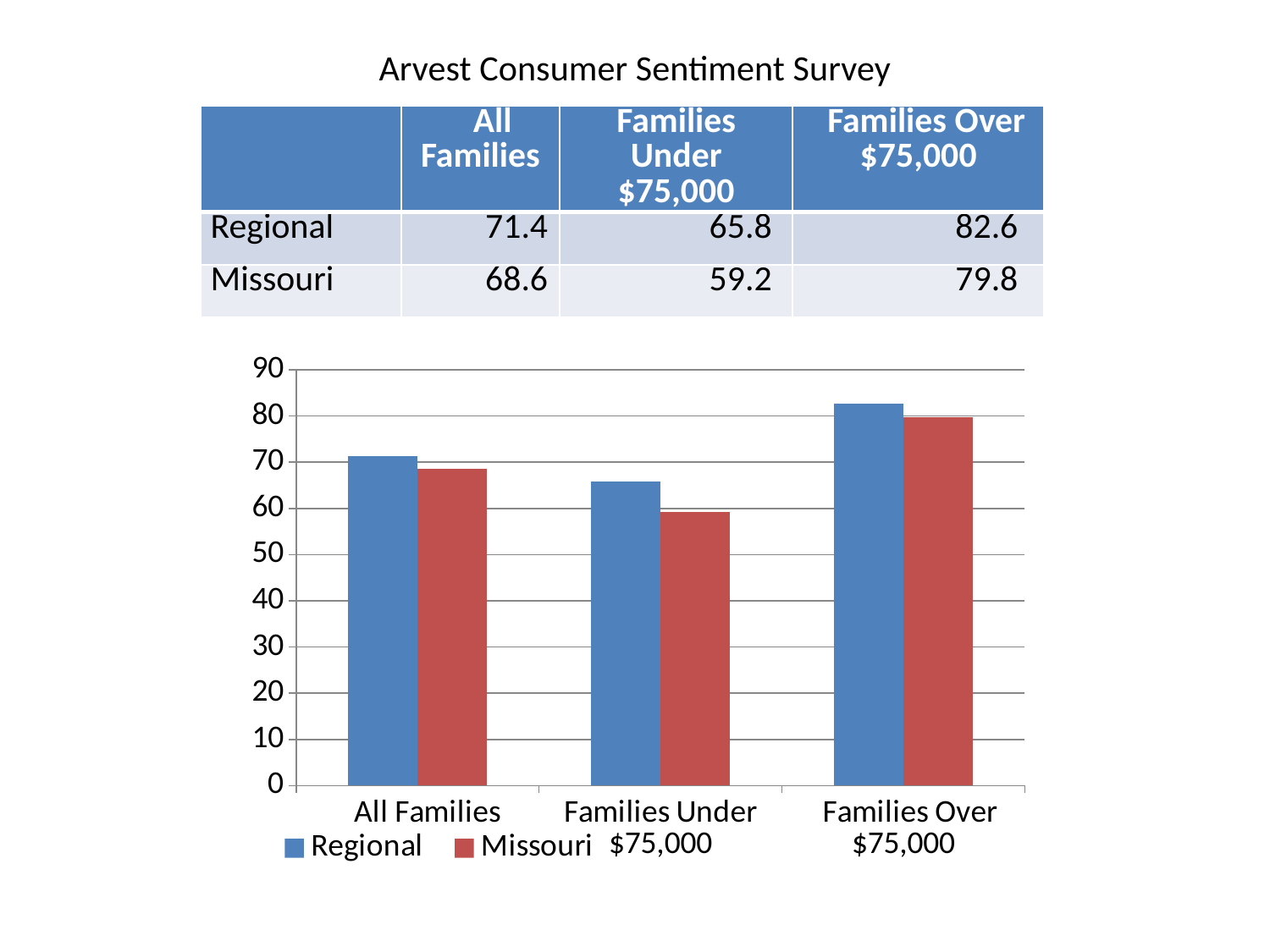
Which is larger for All Families, the Regional value or the Missouri value? Regional Which category has the highest Regional value? Families Over $75,000 What is the Regional value for All Families? 71.4 What is the Missouri value for Families Over $75,000? 79.8 How many series does the chart legend list? 2 Is the Regional value for Families Over $75,000 greater or less than 80? greater What is the Missouri value for Families Under $75,000? 59.2 What colour are the Missouri bars in the chart? red What kind of chart is shown on the slide? bar chart Which category has the lowest Missouri value? Families Under $75,000 How many categories are shown on the x axis of the chart? 3 What is the difference between the Regional and Missouri values for Families Under $75,000? 6.6